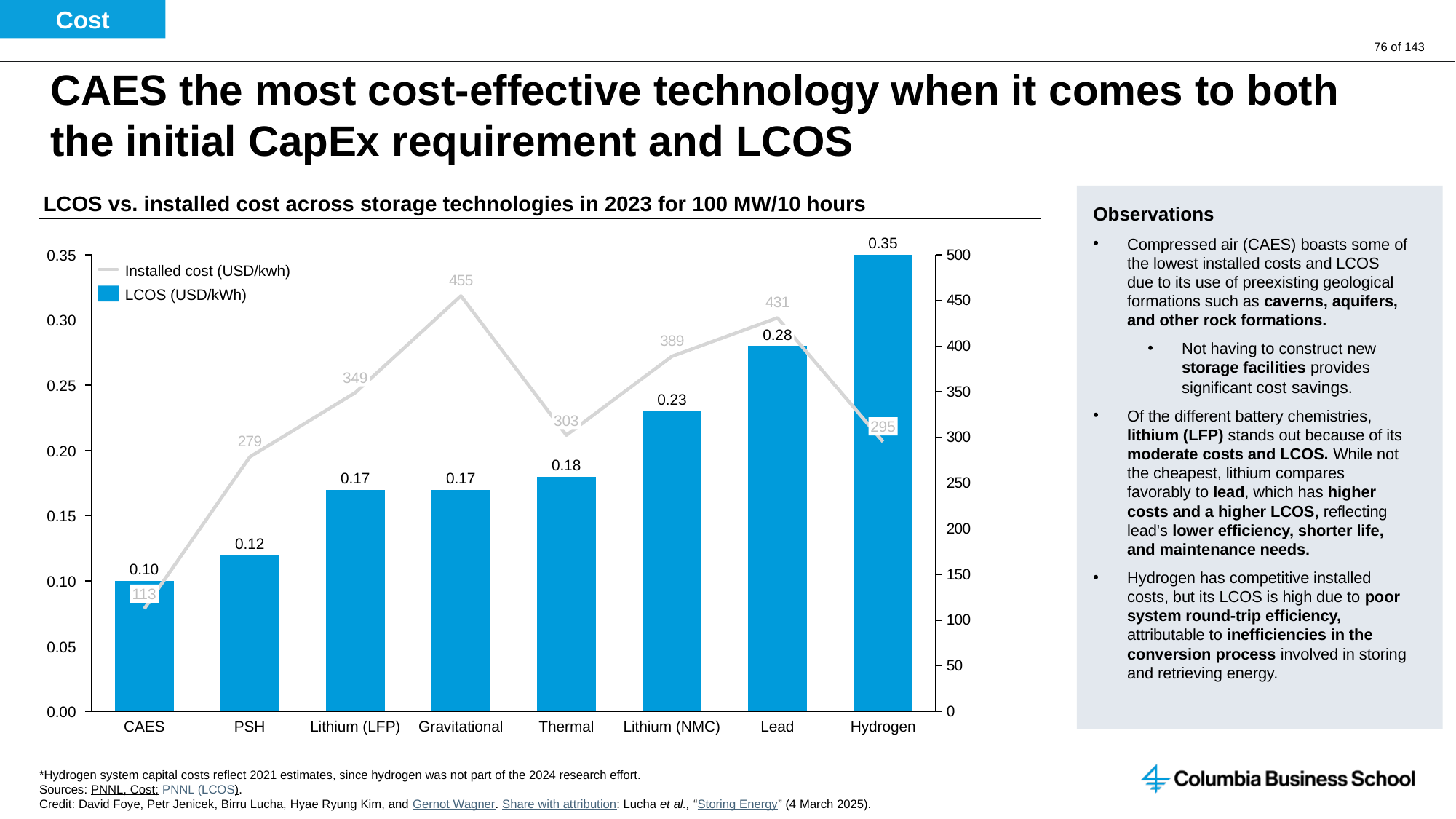
What is the difference in LCOS (USD/kWh) between Hydrogen and CAES? 0.25 Which storage technology has the lowest installed cost (USD/kwh)? CAES Which storage technology has the highest LCOS (USD/kWh)? Hydrogen How many storage technologies are shown on the x axis? 8 What is the difference in installed cost (USD/kwh) between Lead and PSH? 152 How many series does the legend list? 2 What is the installed cost (USD/kwh) for Hydrogen? 295 What is the LCOS (USD/kWh) for Lithium (NMC)? 0.23 What is the installed cost (USD/kwh) for Gravitational? 455 Which has a higher installed cost (USD/kwh), Thermal or Lithium (NMC)? Lithium (NMC) Which storage technology has the highest installed cost (USD/kwh)? Gravitational What is the LCOS (USD/kWh) for CAES? 0.10